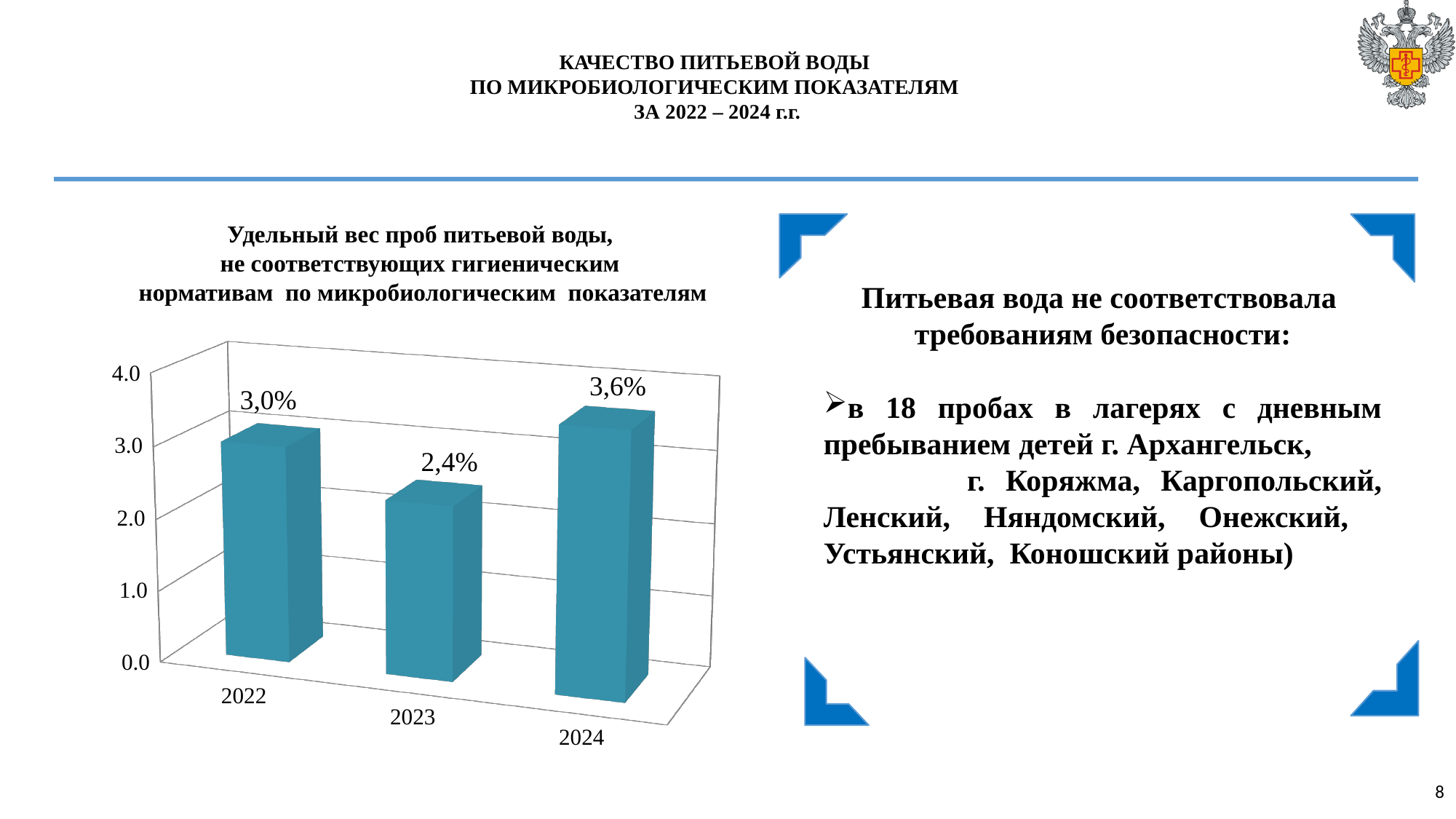
What is the highest value shown on the vertical axis of the chart? 4.0 Which is larger, the value for 2022 or the value for 2023? 2022 What is the value for 2024? 3,6% What is the value for 2022? 3,0% What is the value for 2023? 2,4% What is the difference between the values for 2024 and 2023? 1,2% Is the value for 2024 greater or less than 3.0? greater How many years are shown on the chart? 3 What kind of chart is shown on the slide? bar chart Which year has the lowest value? 2023 What is the difference between the values for 2024 and 2022? 0,6% Which year has the highest value? 2024